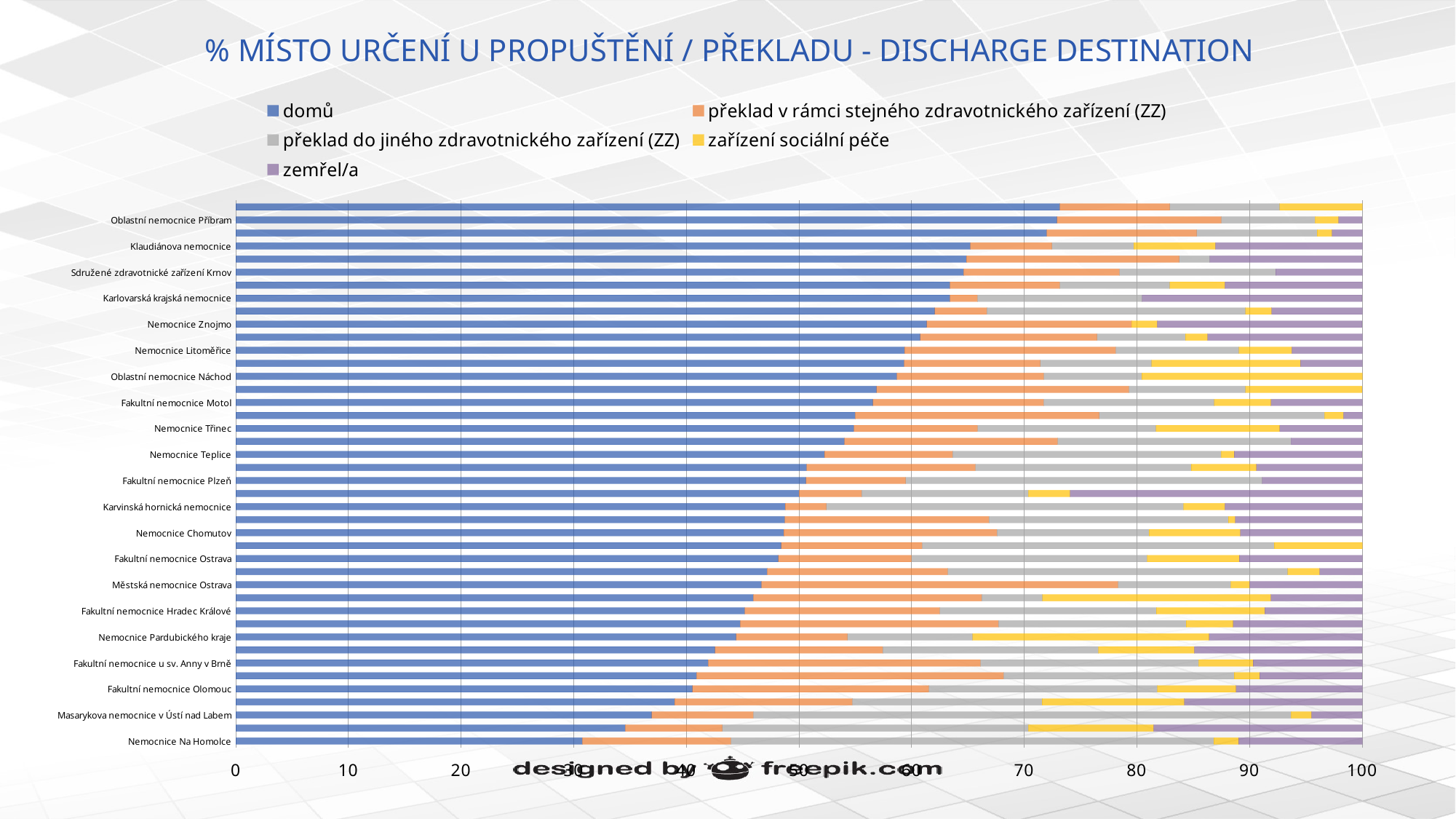
Is the "domů" value for Masarykova nemocnice v Ústí nad Labem greater or less than 40? less What kind of chart is shown on the slide? Stacked bar chart Is the "domů" value for Fakultní nemocnice Hradec Králové greater or less than 50? less Does the "domů" share rise or fall moving from the top of the chart to the bottom? Fall Is the "domů" value for Nemocnice Na Homolce greater or less than 40? less Which labelled hospital has the lowest "domů" share? Nemocnice Na Homolce Which colour represents the series "domů" in the chart? Blue Which has the larger "domů" share, Oblastní nemocnice Příbram or Nemocnice Na Homolce? Oblastní nemocnice Příbram How many series does the legend list? 5 What is the title of the chart? % MÍSTO URČENÍ U PROPUŠTĚNÍ / PŘEKLADU - DISCHARGE DESTINATION